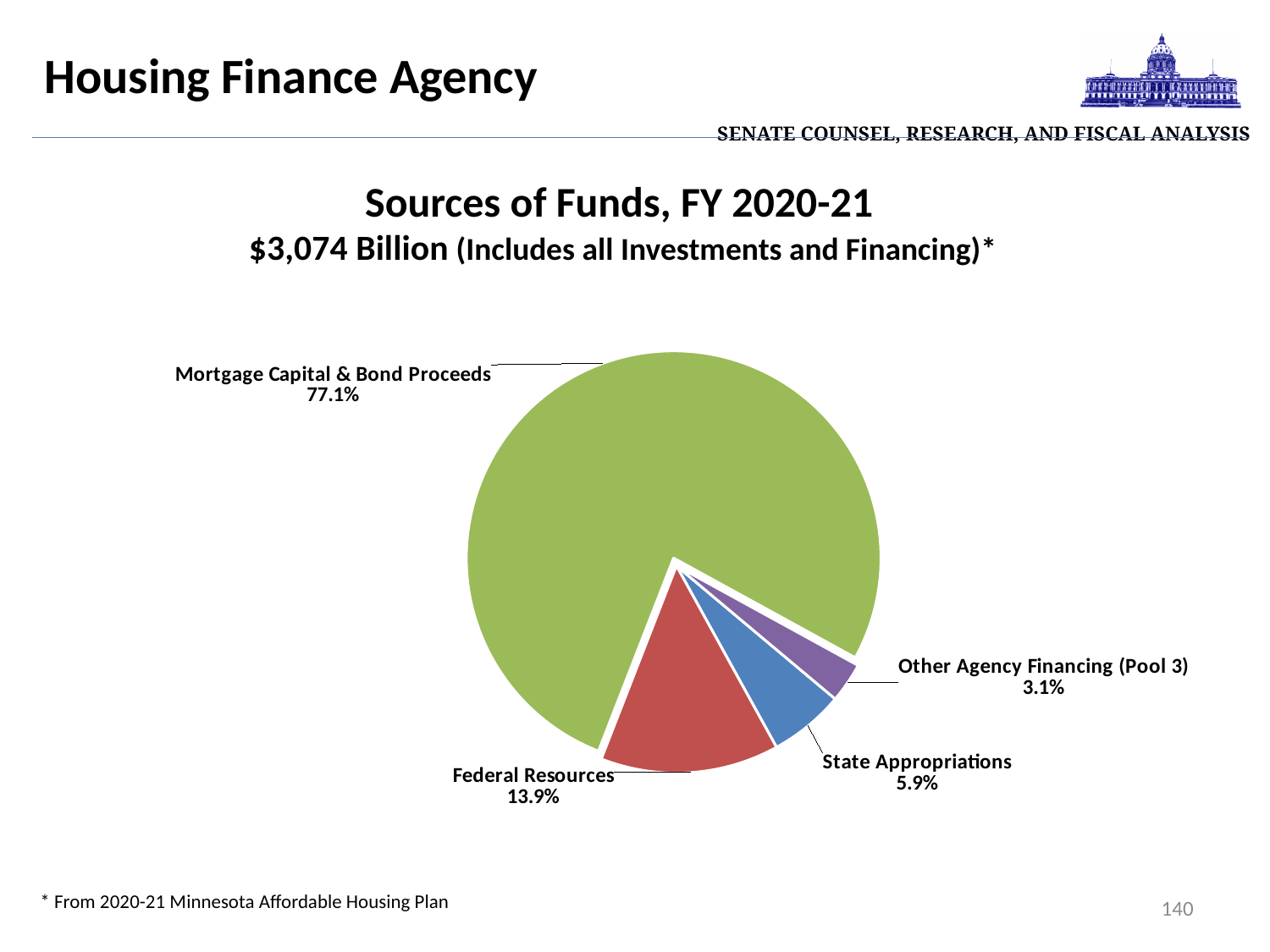
What share of funds comes from Other Agency Financing (Pool 3)? 3.1% Which source of funds has the smallest share? Other Agency Financing (Pool 3) What share of funds comes from State Appropriations? 5.9% What total amount of funds does the chart subtitle state? $3,074 Billion How many slices does the pie chart have? 4 What is the difference in percentage points between Federal Resources and State Appropriations? 8.0 Which is larger, the share for State Appropriations or the share for Other Agency Financing (Pool 3)? State Appropriations What share of funds comes from Federal Resources? 13.9% Which source of funds has the largest share? Mortgage Capital & Bond Proceeds What is the title of the chart? Sources of Funds, FY 2020-21 What share of funds comes from Mortgage Capital & Bond Proceeds? 77.1% What type of chart is shown on the slide? pie chart